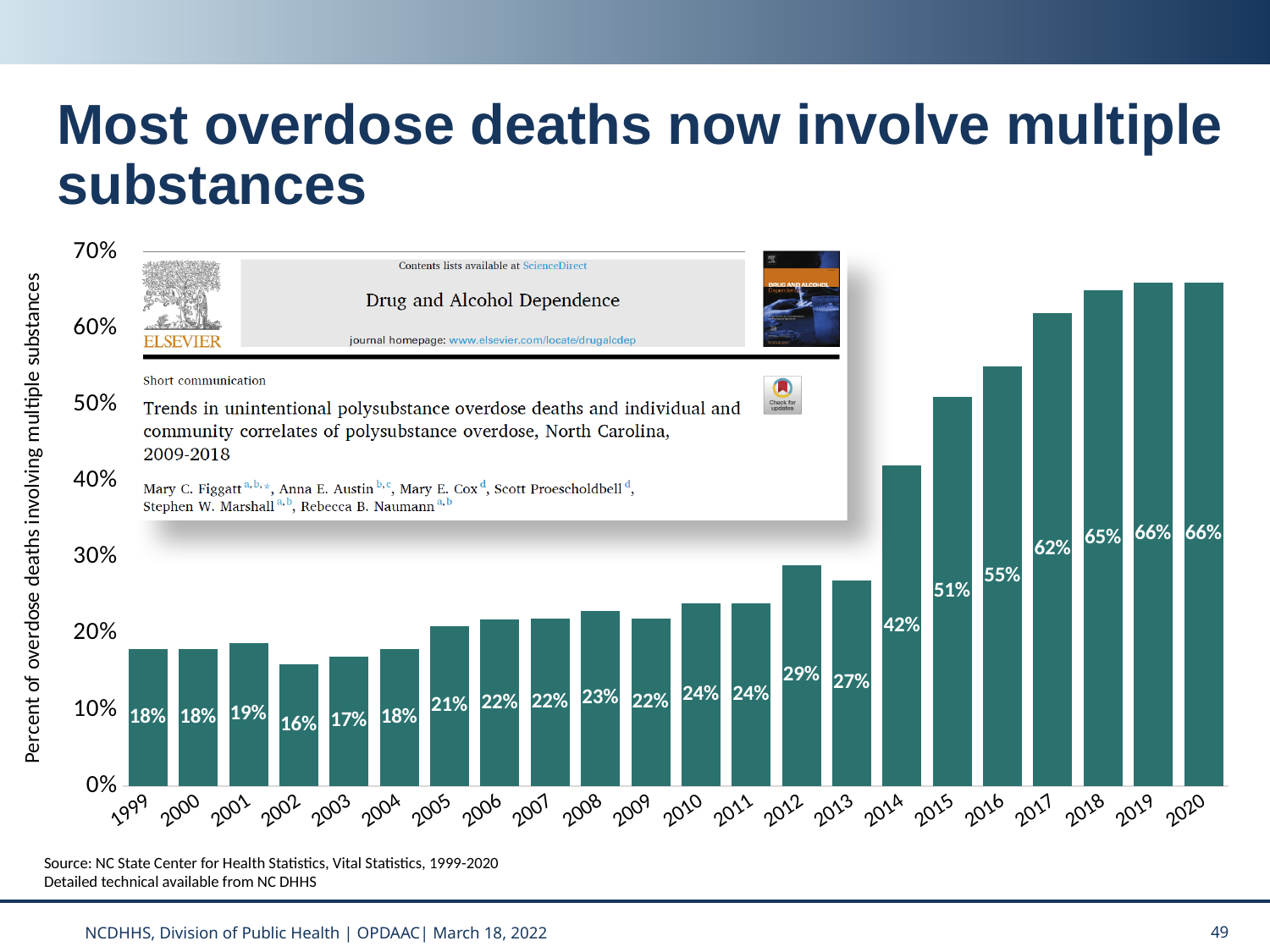
What is the value shown for 2002? 16% What is the difference between the values for 2015 and 2014? 9 percentage points What is the label of the vertical axis? Percent of overdose deaths involving multiple substances Which year has the lowest percent of overdose deaths involving multiple substances? 2002 What kind of chart is shown on the slide? Bar chart What is the difference between the values for 2020 and 1999? 48 percentage points How many years are shown on the x axis? 22 What is the value shown for 2017? 62% What percent of overdose deaths involved multiple substances in 2014? 42% Which year has the larger value, 2012 or 2013? 2012 Is the value for 2016 greater or less than 50%? greater Do the values generally rise or fall from 1999 to 2020? Rise